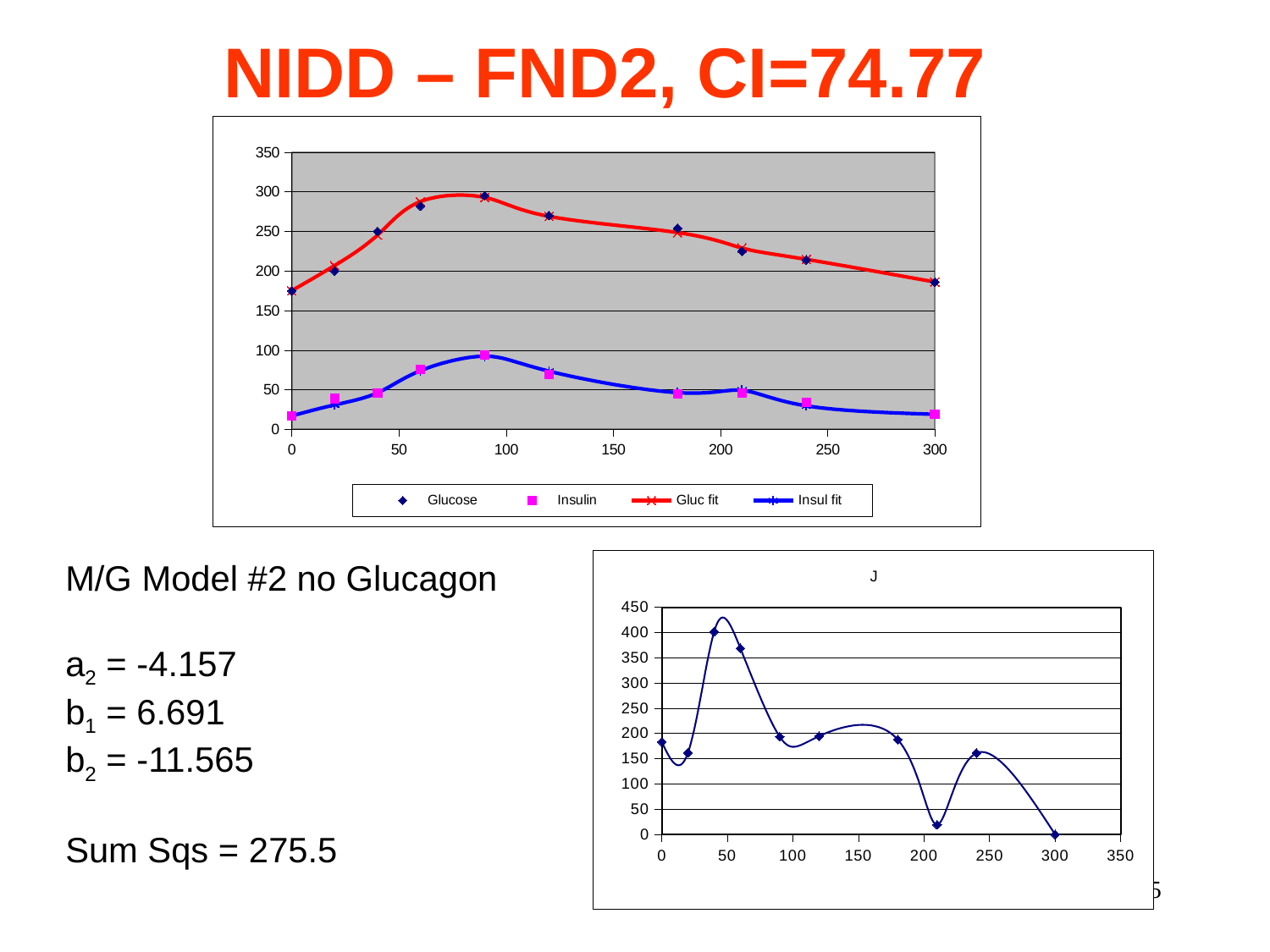
In the top chart, do the Glucose values rise or fall between x = 90 and x = 300? fall In the top chart, at which x value does the Glucose series reach its highest point? 90 In the chart titled J, how many data points are plotted? 10 In the top chart, how many series does the legend list? 4 In the top chart, is the Glucose value at x = 90 greater or less than 250? greater What is the title of the chart at the bottom right of the slide? J In the top chart, what are the names of the series in the legend? Glucose, Insulin, Gluc fit, Insul fit In the chart titled J, is the value at x = 210 greater or less than 50? less In the top chart, which is larger at x = 0, the Glucose value or the Insulin value? Glucose In the top chart, is the Insulin value at x = 90 greater or less than 100? less In the chart titled J, at which x value is the plotted value lowest? 300